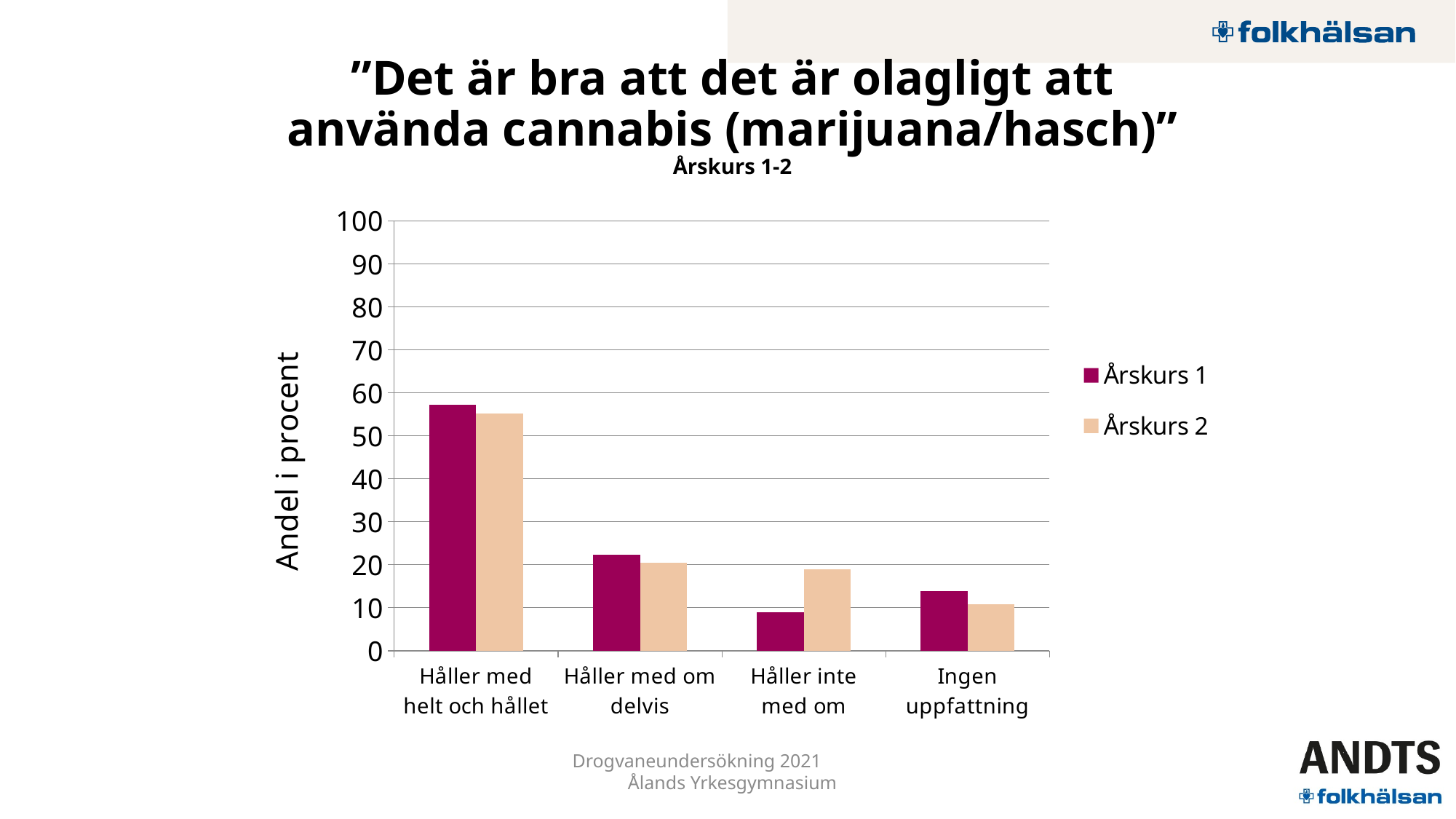
How many series does the legend list? 2 Is the value for Årskurs 2 in 'Håller inte med om' greater or less than 10? greater Which category has the lowest value for Årskurs 1? Håller inte med om Which category has the highest value for Årskurs 1? Håller med helt och hållet For 'Håller inte med om', which series has the larger value, Årskurs 1 or Årskurs 2? Årskurs 2 How many response categories are shown on the x axis? 4 What is the label of the vertical axis? Andel i procent What kind of chart is shown on the slide? bar chart Which category has the lowest value for Årskurs 2? Ingen uppfattning Is the value for Årskurs 2 in 'Ingen uppfattning' greater or less than 20? less Is the value for Årskurs 1 in 'Håller med helt och hållet' greater or less than 50? greater For 'Ingen uppfattning', which series has the larger value, Årskurs 1 or Årskurs 2? Årskurs 1